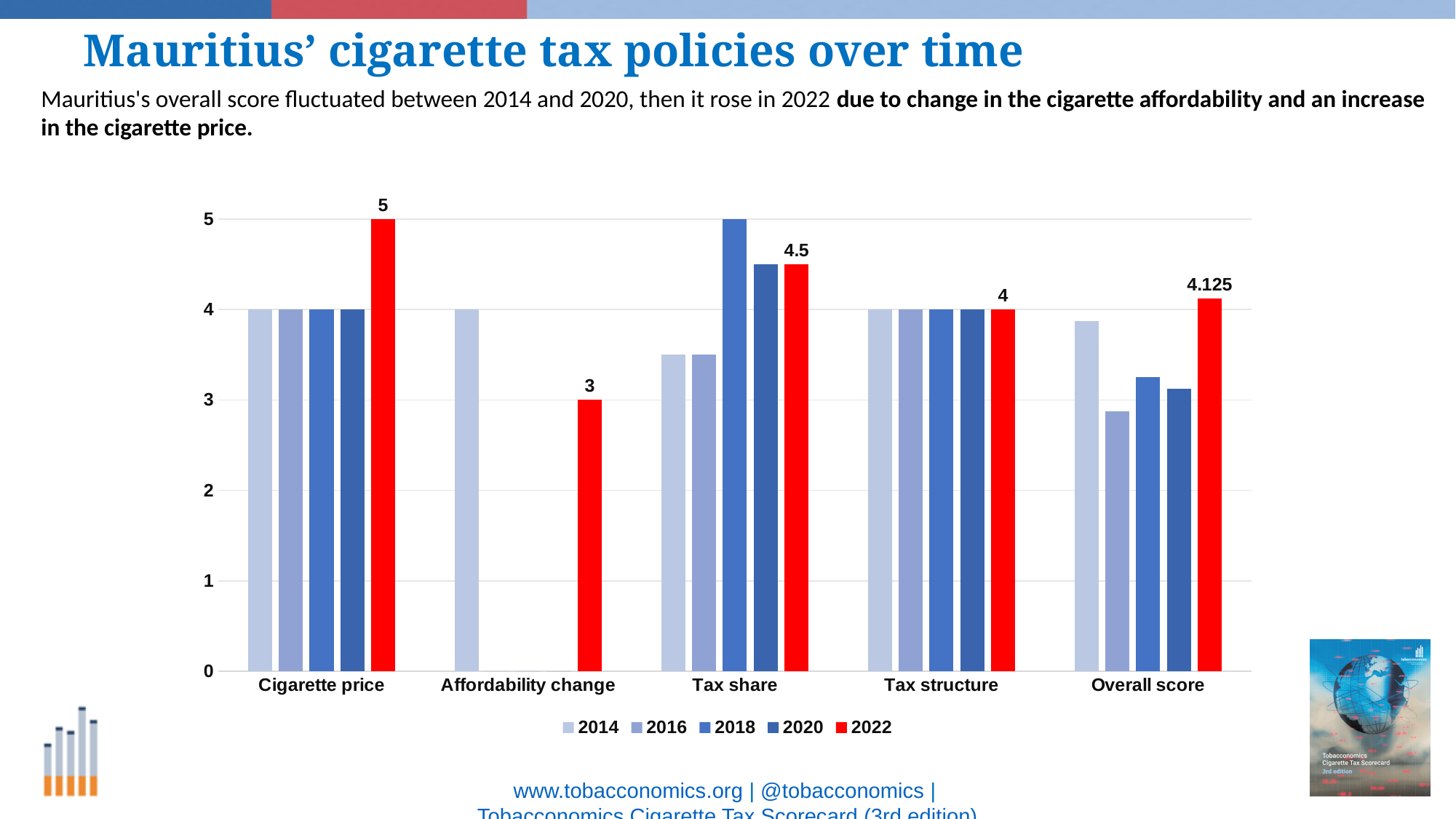
What is the difference between the 2022 values for Cigarette price and Affordability change? 2 What kind of chart is shown on the slide? bar chart What is the value for Tax share in 2022? 4.5 Which category has the lowest value for 2022? Affordability change What is the value for Cigarette price in 2022? 5 How many series does the legend list? 5 What is the value for Tax structure in 2022? 4 Is the Overall score for 2016 greater or less than 3? less What is the value for Affordability change in 2022? 3 Which is larger in 2022: Tax share or Overall score? Tax share Which category has the highest value for 2022? Cigarette price What is the Overall score for 2022? 4.125